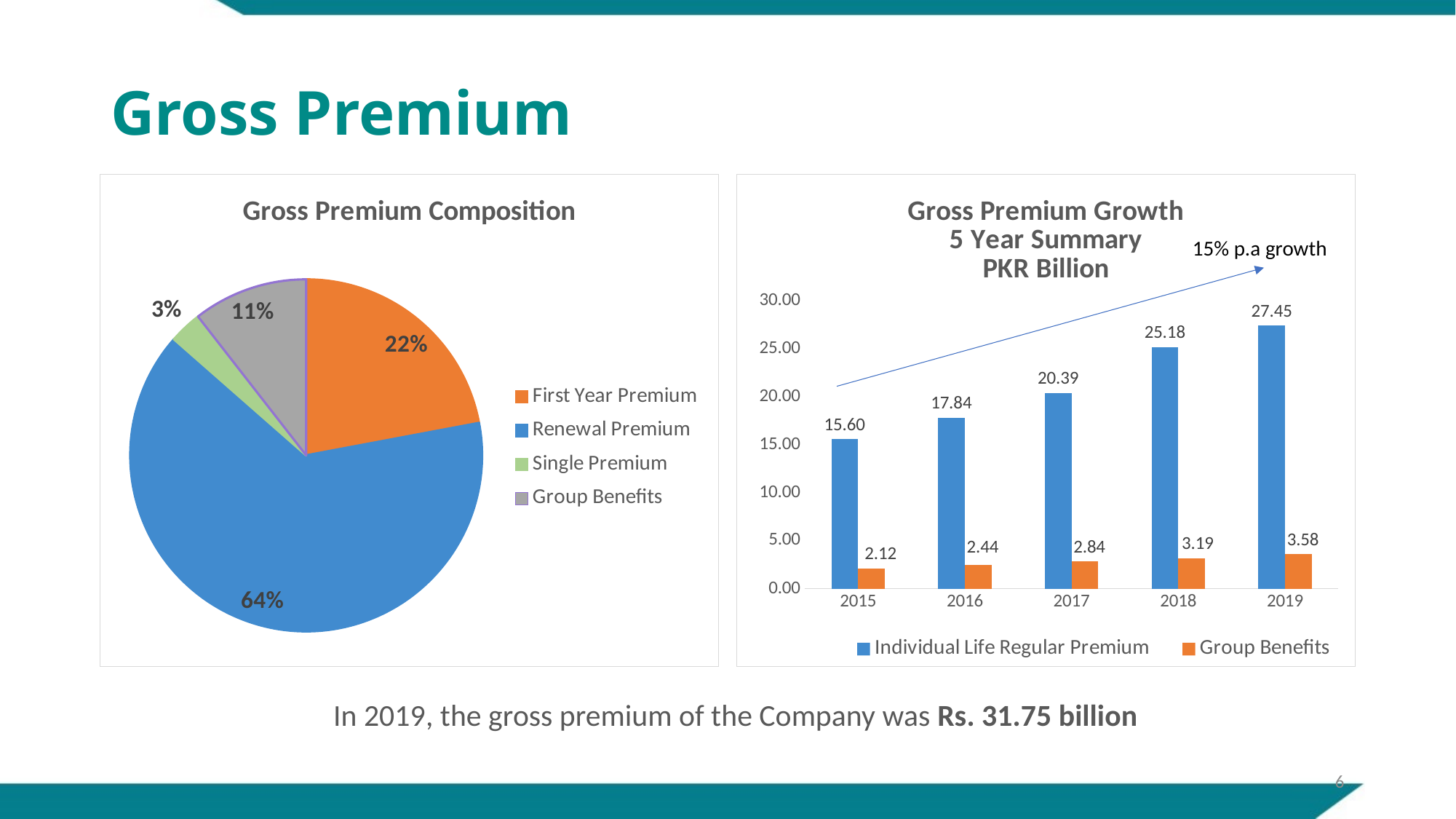
What kind of chart is the Gross Premium Composition chart? Pie chart In the Gross Premium Growth chart, what is the value for Individual Life Regular Premium in 2017? 20.39 In the Gross Premium Composition chart, which category has the smallest slice? Single Premium In the Gross Premium Growth chart, what is the difference between the Individual Life Regular Premium values for 2019 and 2015? 11.85 In the Gross Premium Growth chart, which year has the highest Individual Life Regular Premium value? 2019 In the Gross Premium Growth chart, what is the value for Group Benefits in 2019? 3.58 In the Gross Premium Composition chart, what share does First Year Premium have? 22% In the Gross Premium Composition chart, what is the difference between the Group Benefits share and the Single Premium share? 8% In the Gross Premium Growth chart, do the Group Benefits values rise or fall from 2015 to 2019? Rise In the Gross Premium Growth chart, how many series does the legend list? 2 In the Gross Premium Composition chart, what share does Renewal Premium have? 64% In the Gross Premium Composition chart, how many slices does the pie have? 4